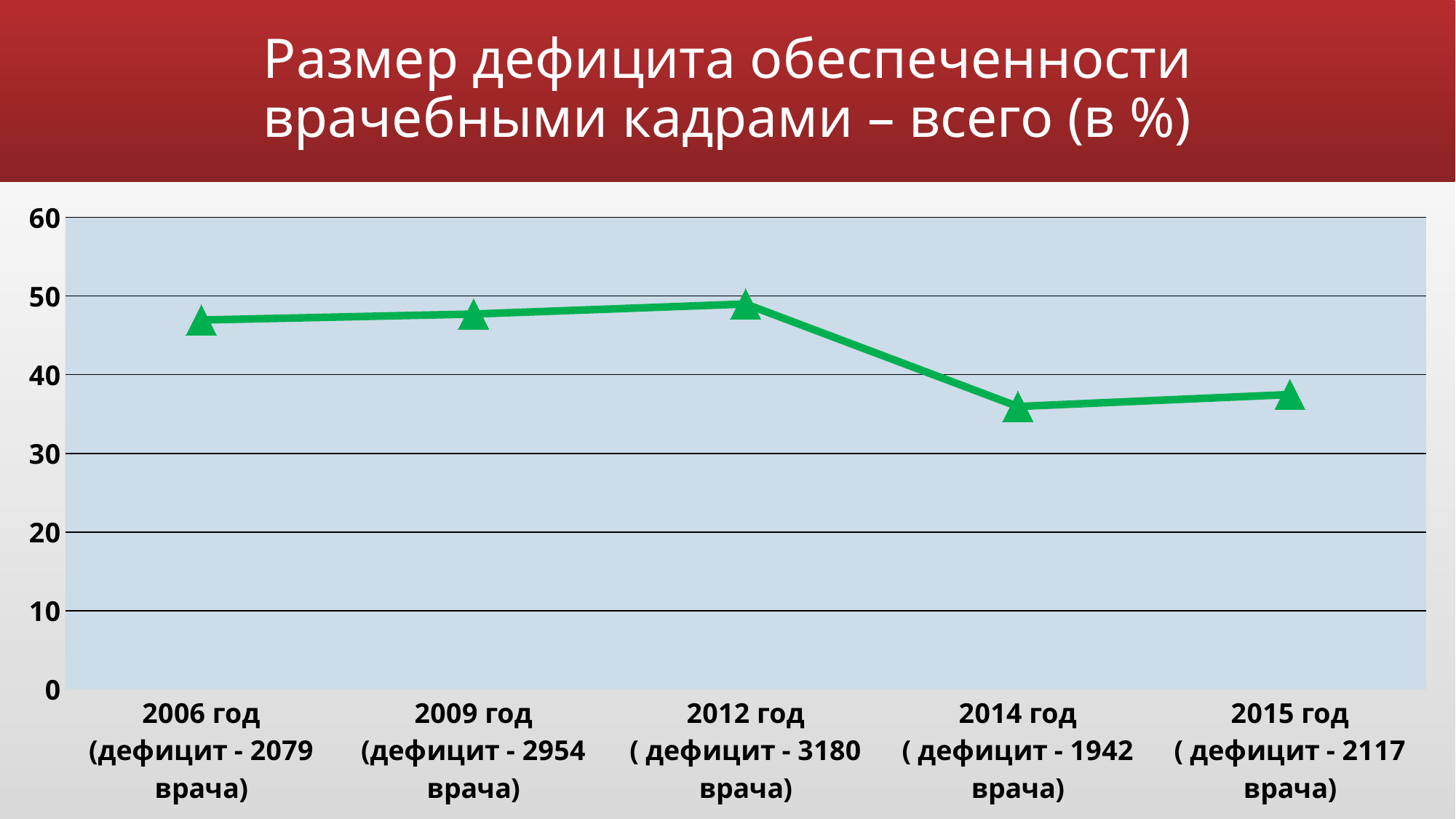
Does the value rise or fall between 2012 год and 2014 год? Fall Is the value for 2015 год greater or less than 30? greater How many data points (years) are plotted on the chart? 5 Is the value for 2006 год greater or less than 40? greater Which year has the highest value on the chart? 2012 год What kind of chart is shown on the slide? Line chart Is the value for 2014 год greater or less than 40? less Which is larger, the value for 2006 год or the value for 2015 год? 2006 год Which is larger, the value for 2012 год or the value for 2014 год? 2012 год According to the category label, what is the deficit in doctors noted for 2012 год? 3180 врача What is the title of the chart on the slide? Размер дефицита обеспеченности врачебными кадрами – всего (в %)